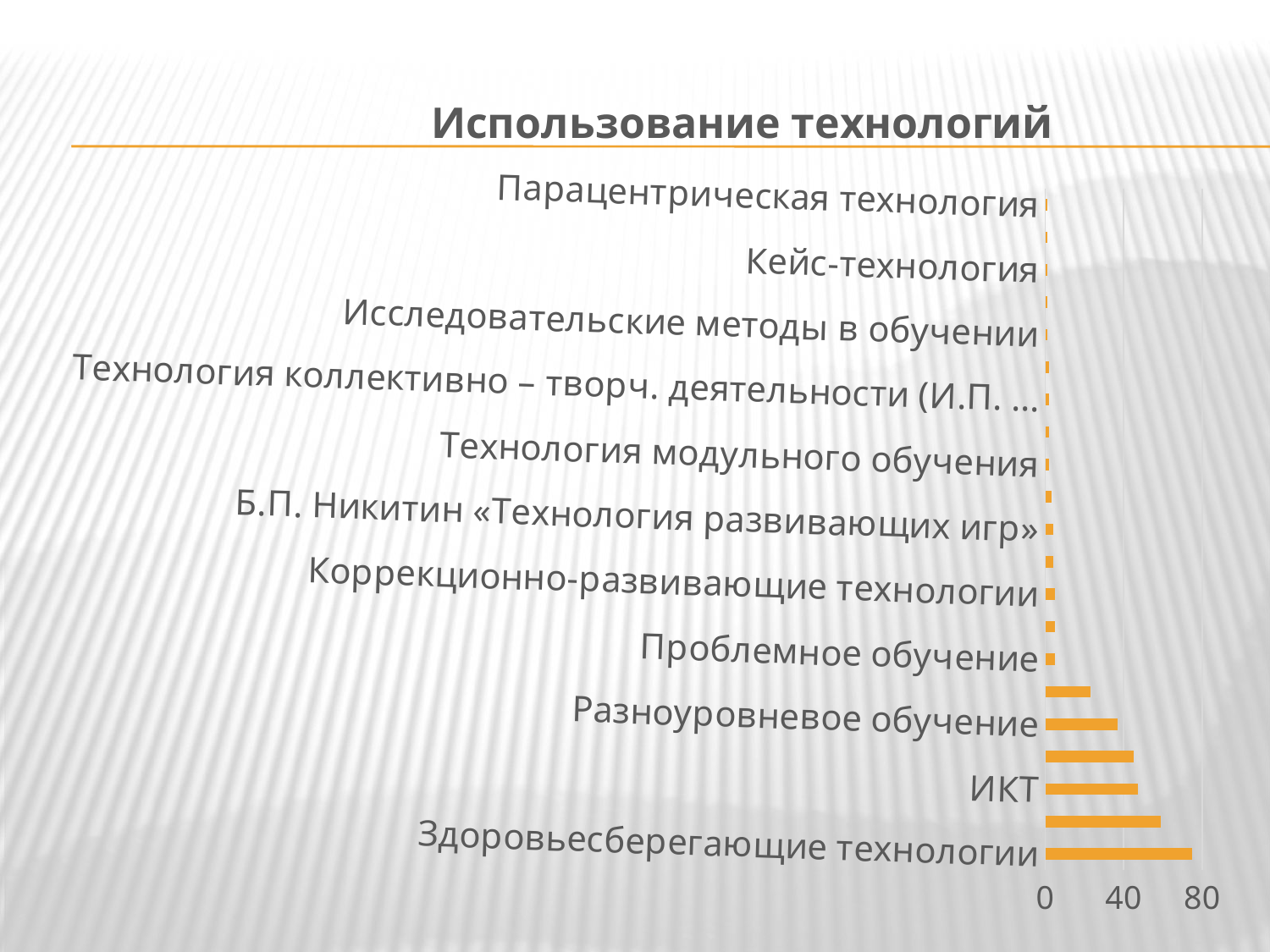
Which is larger, the value for Разноуровневое обучение or the value for Технология модульного обучения? Разноуровневое обучение Is the value for Проблемное обучение greater or less than 40? less What colour are the bars in the chart? orange What is the highest tick value shown on the horizontal axis? 80 What kind of chart is shown on the slide? bar chart Which is larger, the value for Здоровьесберегающие технологии or the value for ИКТ? Здоровьесберегающие технологии Which is larger, the value for ИКТ or the value for Проблемное обучение? ИКТ Is the value for Здоровьесберегающие технологии greater or less than 40? greater Which category has the highest value? Здоровьесберегающие технологии What is the title of the chart? Использование технологий Is the value for Кейс-технология greater or less than 40? less